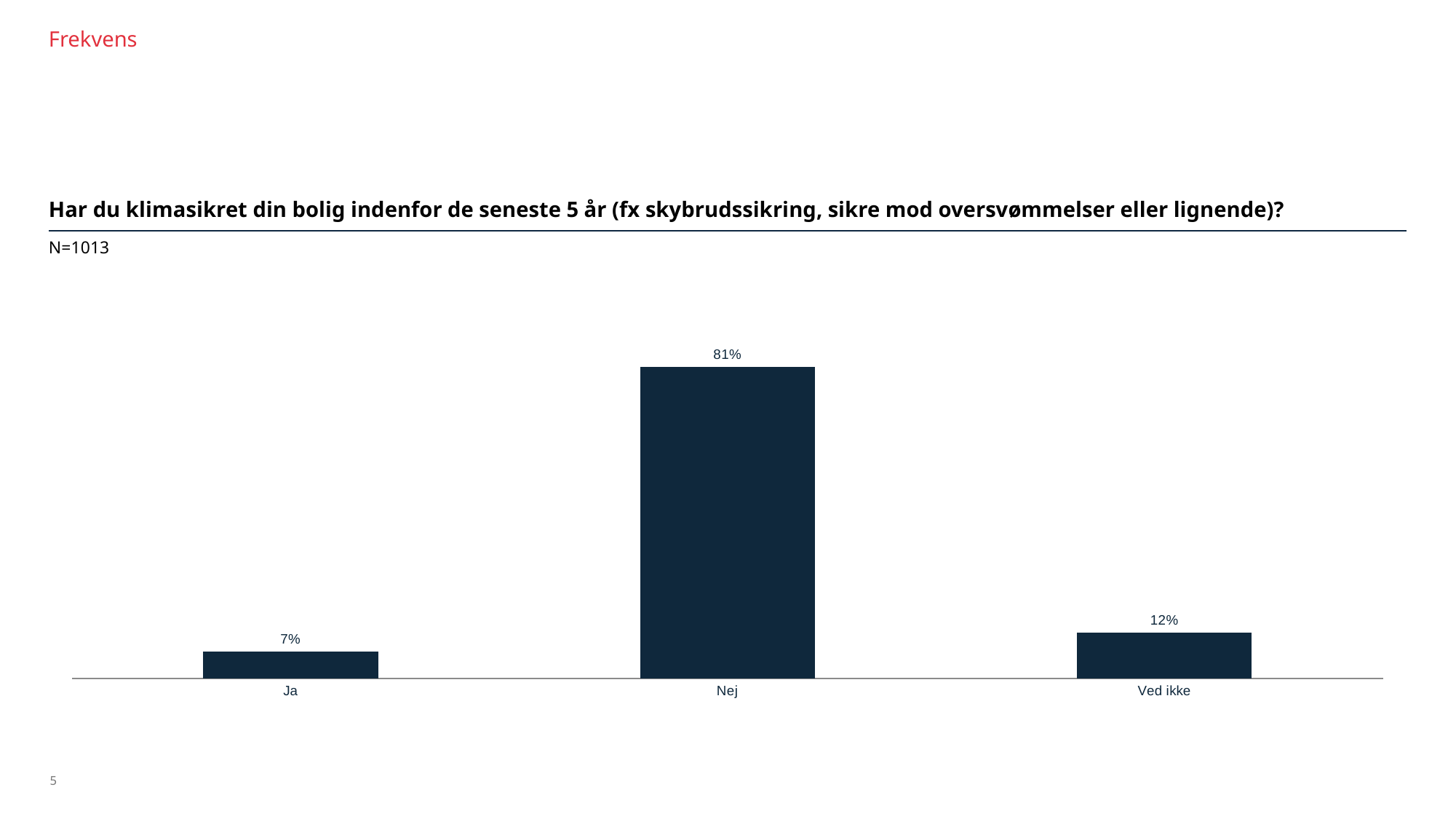
How many categories are shown on the x axis? 3 Which category has the highest value? Nej Which is larger, the value for Ja or the value for Ved ikke? Ved ikke What is the value for Ved ikke? 12% What is the total of the three values shown? 100% What is the difference between the values for Ved ikke and Ja? 5% What is the value for Ja? 7% What is the value for Nej? 81% What is the difference between the values for Nej and Ved ikke? 69% What kind of chart is shown on the slide? Bar chart Which category has the lowest value? Ja What is the sample size (N) stated on the slide? N=1013